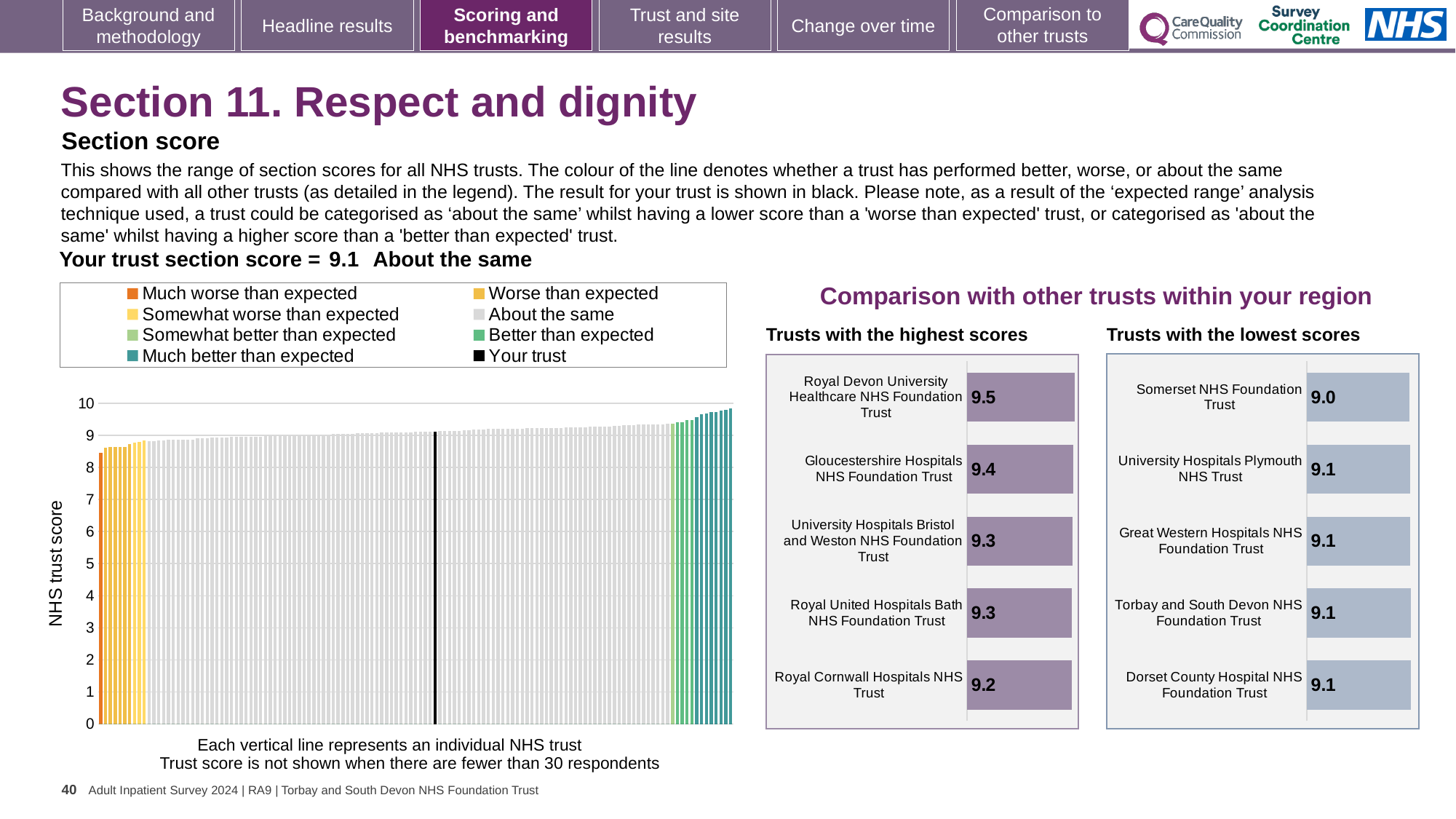
In the large chart on the left, what is the label of the vertical axis? NHS trust score In the 'Trusts with the highest scores' chart, what is the score for Royal Cornwall Hospitals NHS Trust? 9.2 In the 'Trusts with the highest scores' chart, what is the difference between the scores of Royal Devon University Healthcare NHS Foundation Trust and Royal Cornwall Hospitals NHS Trust? 0.3 In the 'Trusts with the lowest scores' chart, which trust has the lowest score? Somerset NHS Foundation Trust In the large chart on the left, how many entries does the legend list? 8 Which is larger: the score for Gloucestershire Hospitals NHS Foundation Trust in the 'Trusts with the highest scores' chart, or the score for Somerset NHS Foundation Trust in the 'Trusts with the lowest scores' chart? Gloucestershire Hospitals NHS Foundation Trust In the 'Trusts with the lowest scores' chart, what is the score for Torbay and South Devon NHS Foundation Trust? 9.1 In the 'Trusts with the highest scores' chart, which trust has the highest score? Royal Devon University Healthcare NHS Foundation Trust In the 'Trusts with the highest scores' chart, how many trusts are listed? 5 In the 'Trusts with the highest scores' chart, what is the score for Royal Devon University Healthcare NHS Foundation Trust? 9.5 In the 'Trusts with the lowest scores' chart, what is the score for Somerset NHS Foundation Trust? 9.0 What kind of chart is the large chart on the left showing NHS trust scores? Bar chart